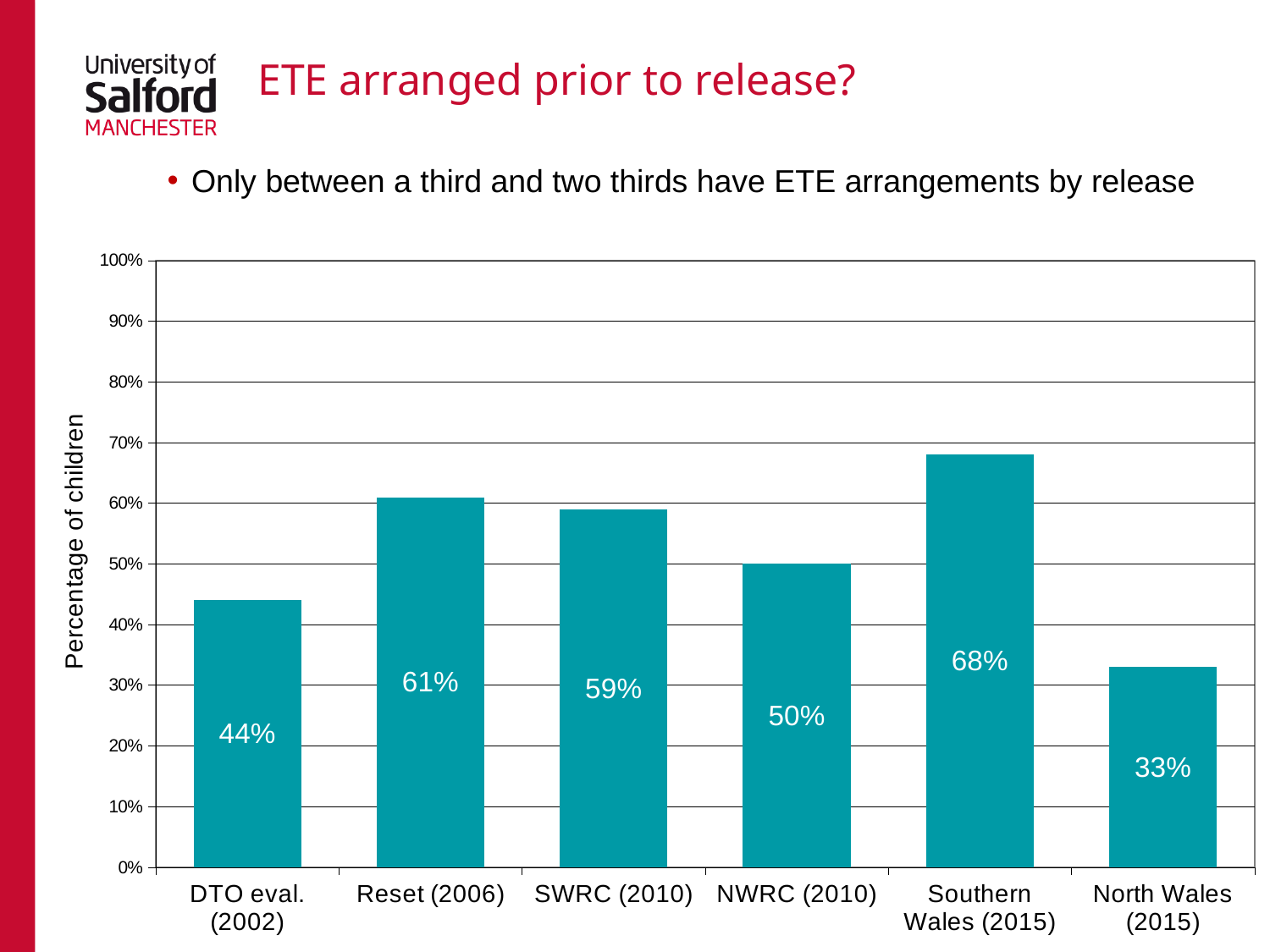
What is the value for DTO eval. (2002)? 44% What kind of chart is shown on the slide? Bar chart What is the difference between Southern Wales (2015) and North Wales (2015)? 35% Which category has the lowest percentage of children? North Wales (2015) What is the value for North Wales (2015)? 33% Is the value for SWRC (2010) greater or less than 50%? greater Which category has the highest percentage of children? Southern Wales (2015) What percentage of children is shown for Reset (2006)? 61% What is the label of the y axis? Percentage of children What is the difference between Reset (2006) and SWRC (2010)? 2% Which is larger, the value for NWRC (2010) or the value for DTO eval. (2002)? NWRC (2010) How many categories are shown on the x axis? 6